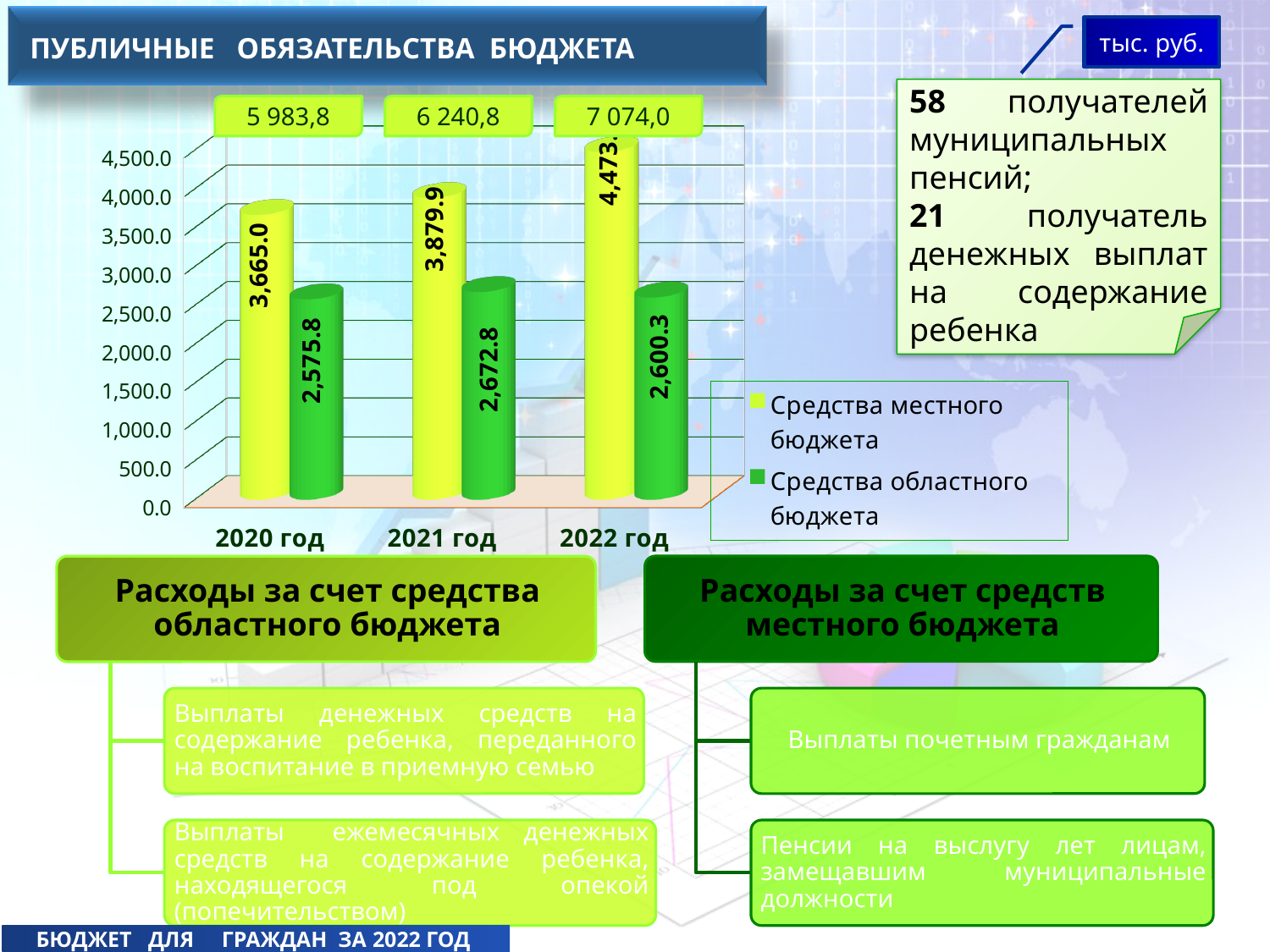
In which year is Средства областного бюджета the lowest? 2020 год Which is larger in 2021 год: Средства местного бюджета or Средства областного бюджета? Средства местного бюджета How many series does the legend list? 2 In which year is Средства областного бюджета the highest? 2021 год What total is printed above the bars for 2021 год? 6 240,8 By how much did Средства местного бюджета increase from 2020 год to 2021 год? 214.9 What is the difference between Средства местного бюджета and Средства областного бюджета in 2020 год? 1,089.2 What is the value for Средства местного бюджета in 2020 год? 3,665.0 What is the value for Средства областного бюджета in 2022 год? 2,600.3 Is the value for Средства местного бюджета in 2022 год greater or less than 4,000.0? greater What is the value for Средства областного бюджета in 2021 год? 2,672.8 Does Средства местного бюджета rise or fall from 2020 год to 2022 год? rise